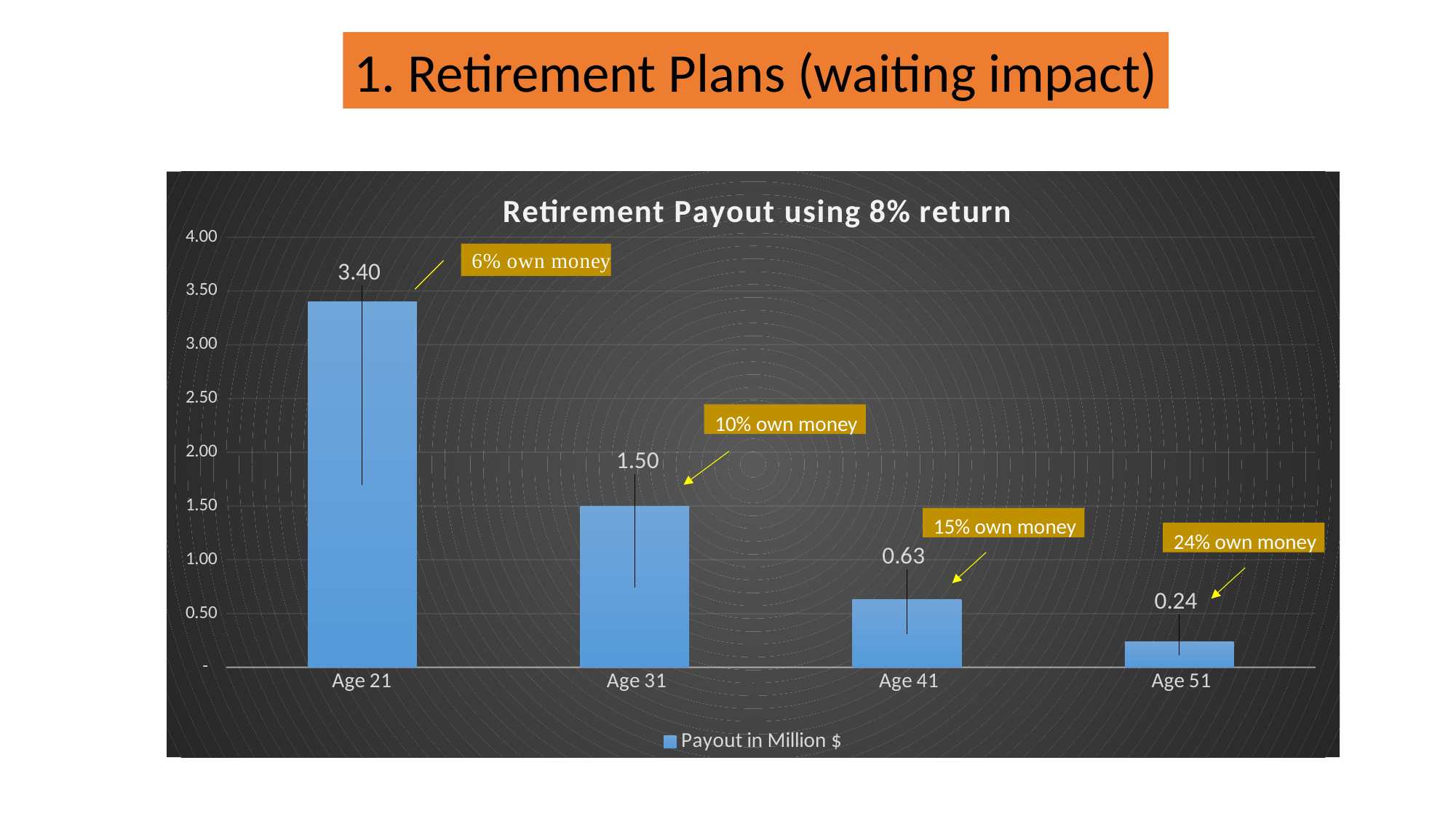
Which age category has the lowest payout? Age 51 Which age category has the highest payout? Age 21 How many age categories are shown on the x axis? 4 What is the payout value for Age 21? 3.40 What is the title of the chart? Retirement Payout using 8% return What is the difference between the payout for Age 21 and the payout for Age 31? 1.90 Which is larger, the payout for Age 41 or the payout for Age 51? Age 41 Do the payout values rise or fall as age increases along the x axis? Fall What is the payout value for Age 31? 1.50 What is the payout value for Age 41? 0.63 What is the payout value for Age 51? 0.24 What kind of chart is shown on the slide? Bar chart